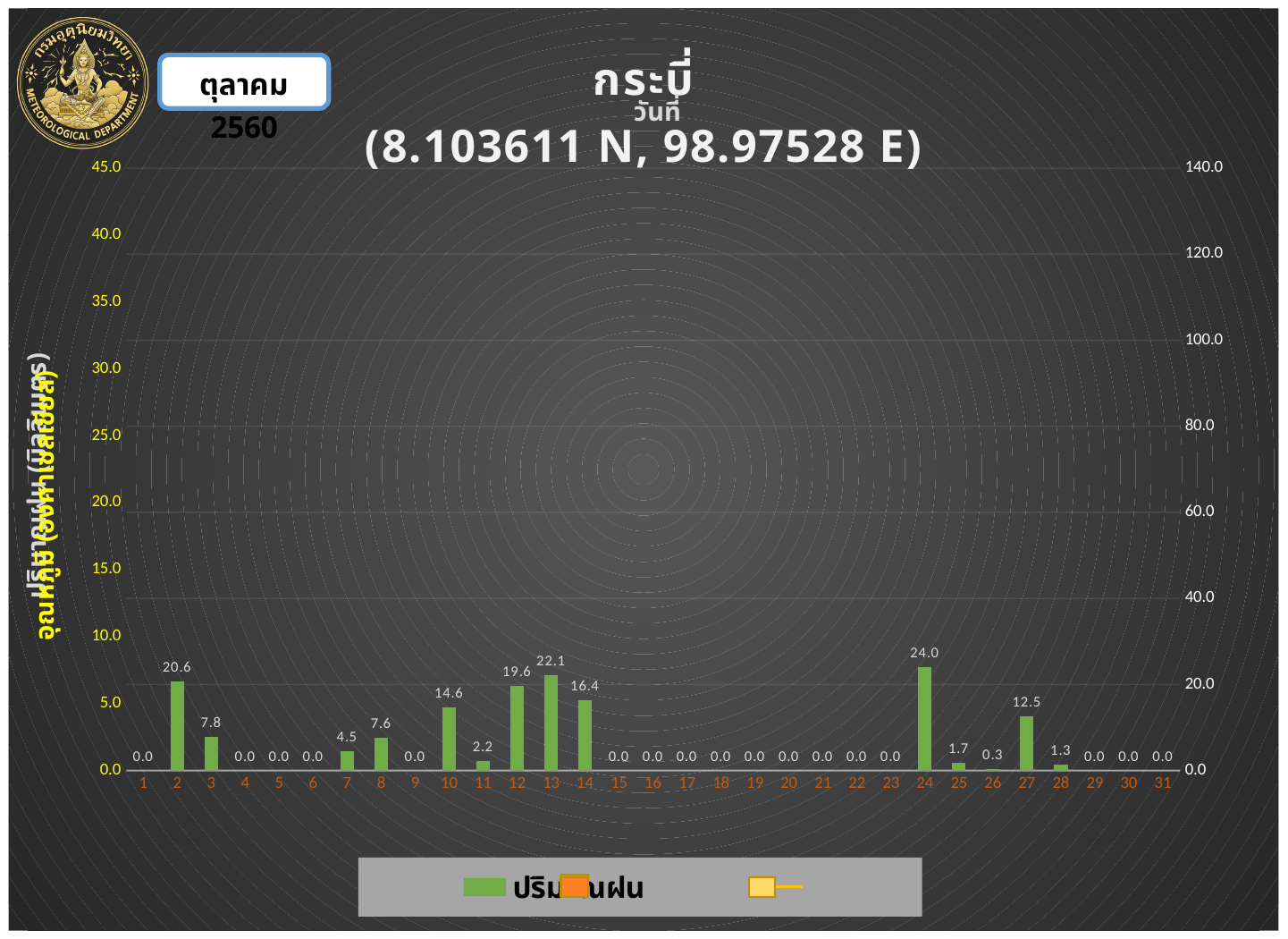
What is the difference between the rainfall values for day 2 and day 3? 12.8 What is the rainfall value for day 24? 24.0 Which day has the highest rainfall value? 24 What is the difference between the rainfall values for day 13 and day 14? 5.7 What kind of chart is shown on the slide? bar chart How many days are shown on the x axis? 31 What is the name of the station shown in the chart title? กระบี่ What is the rainfall value for day 13? 22.1 What is the rainfall value for day 27? 12.5 Which is larger, the rainfall value for day 12 or for day 14? day 12 What is the rainfall value for day 10? 14.6 Which is larger, the rainfall value for day 7 or for day 8? day 8